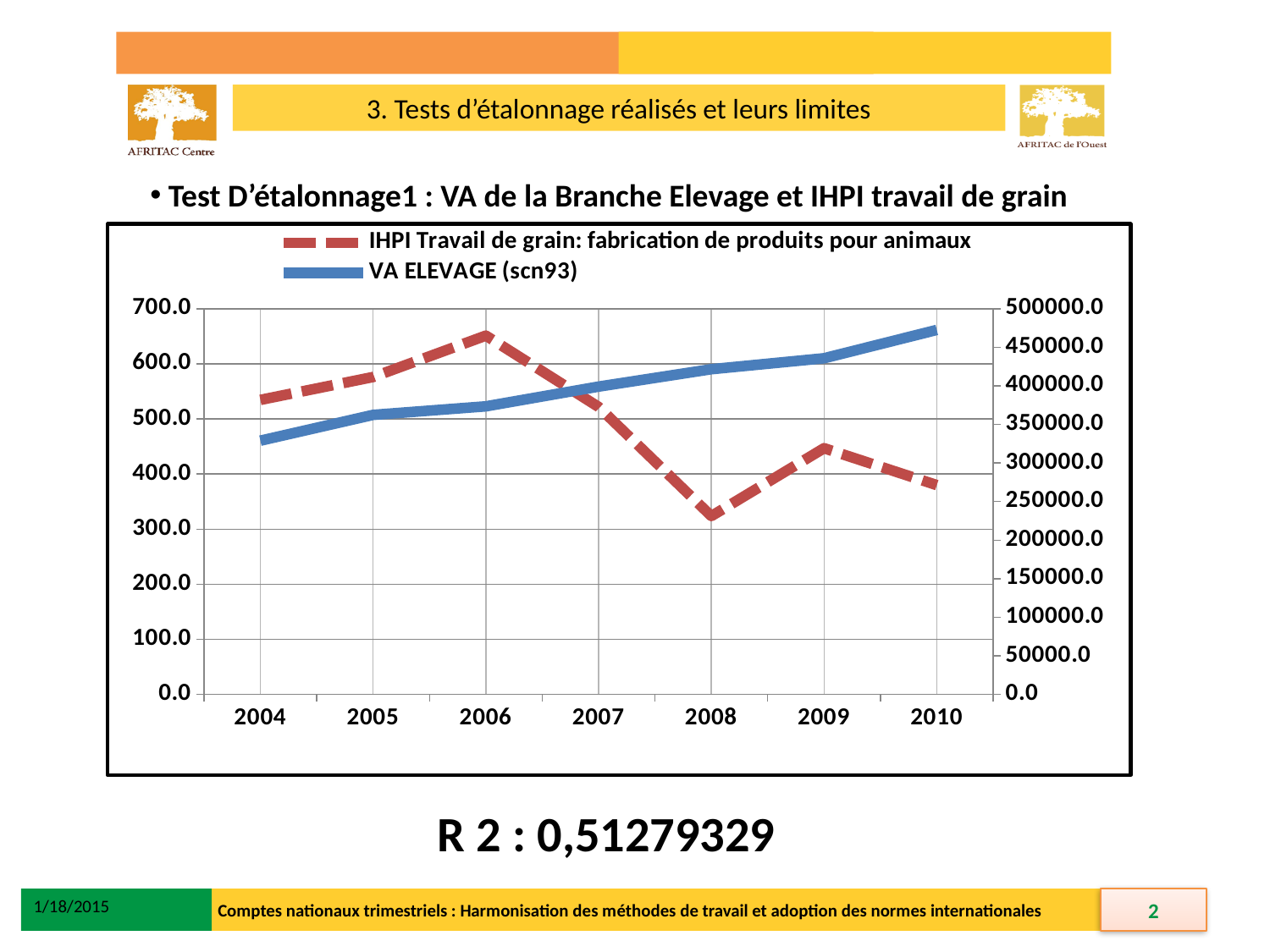
Is the IHPI Travail de grain value for 2006 greater or less than 600.0 on the left axis? greater Is the IHPI Travail de grain value for 2008 greater or less than 400.0 on the left axis? less Does the VA ELEVAGE (scn93) series rise or fall from 2004 to 2010? rise In which year does the IHPI Travail de grain series reach its lowest value? 2008 What kind of chart is shown on the slide? line chart In which year does the IHPI Travail de grain series reach its highest value? 2006 In which year is VA ELEVAGE (scn93) highest? 2010 In which year is VA ELEVAGE (scn93) lowest? 2004 Is the VA ELEVAGE (scn93) value for 2010 greater or less than 450000.0 on the right axis? greater How many years are plotted along the x axis? 7 Which series is drawn with a dashed red line? IHPI Travail de grain: fabrication de produits pour animaux How many series does the legend list? 2